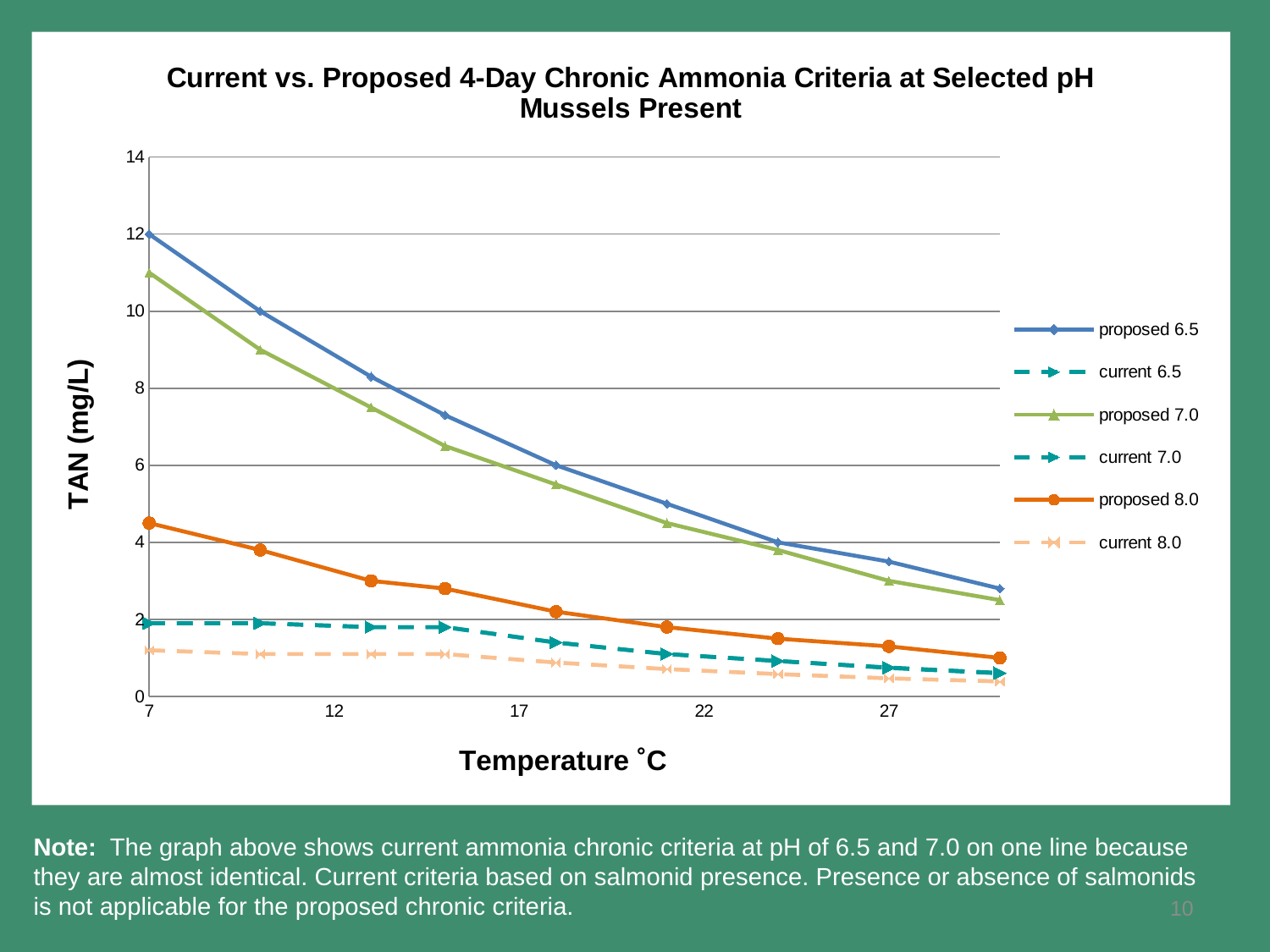
Is the value for proposed 8.0 at 7 °C greater or less than 4? greater Which series has the lowest value at 7 °C? current 8.0 At 7 °C, which is larger: proposed 6.5 or proposed 7.0? proposed 6.5 What kind of chart is shown on the slide? line chart How many series does the legend list? 6 Is the value for current 8.0 at 7 °C greater or less than 2? less Do the values of the proposed 6.5 series rise or fall as temperature increases? fall What is the value of the proposed 6.5 series at 7 °C? 12 Is the value for proposed 7.0 at 7 °C greater or less than 10? greater What is the label of the y axis? TAN (mg/L) Which series has the highest value at 7 °C? proposed 6.5